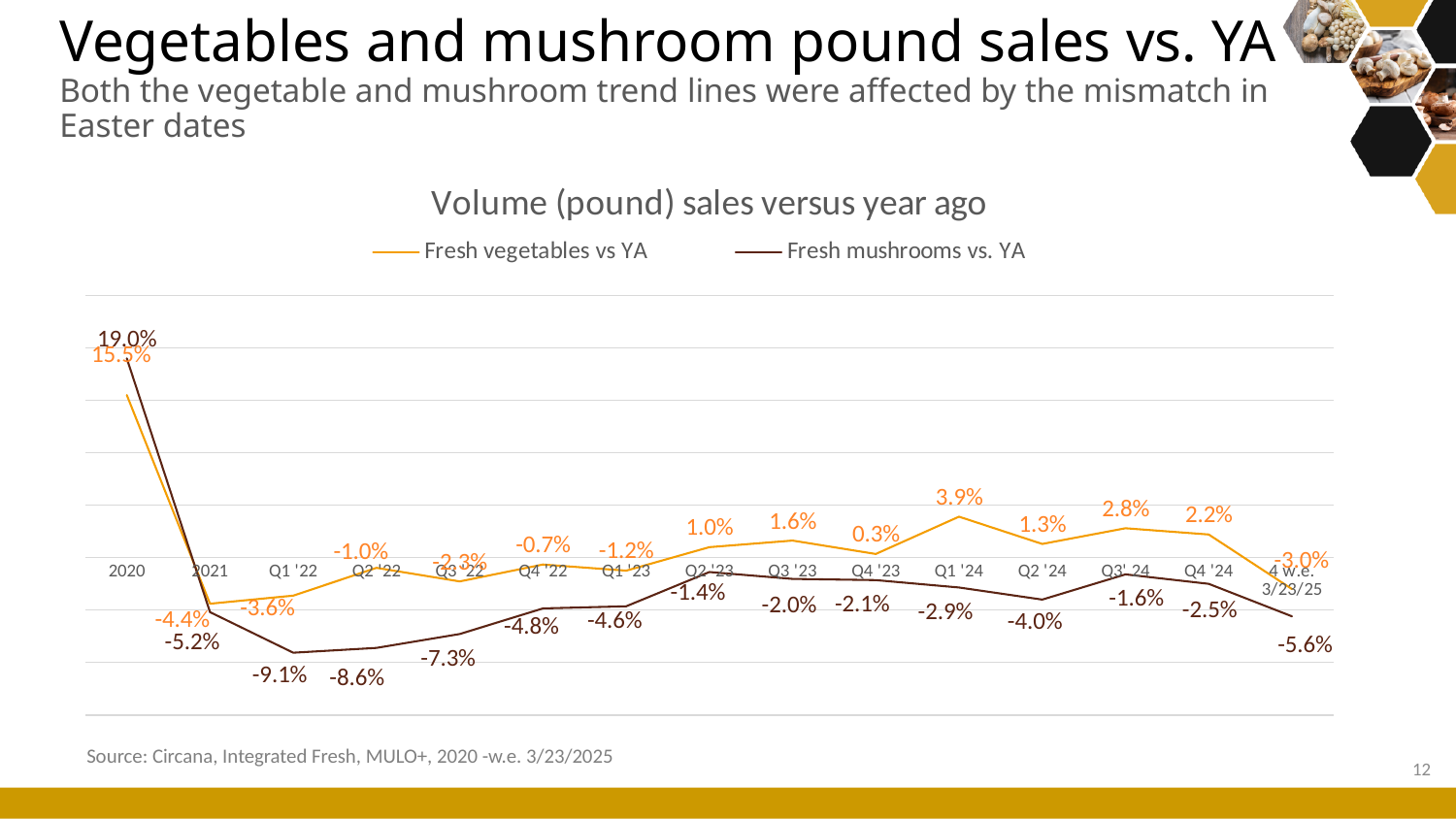
What is the value for Fresh vegetables vs YA in Q1 '24? 3.9% How many series does the legend list? 2 Which series is drawn with the orange line? Fresh vegetables vs YA What is the value for Fresh mushrooms vs. YA in Q1 '22? -9.1% How many time periods are plotted along the x axis? 15 What is the value for Fresh vegetables vs YA for the 4 w.e. 3/23/25 period? -3.0% In Q4 '24, which series has the larger value, Fresh vegetables vs YA or Fresh mushrooms vs. YA? Fresh vegetables vs YA What kind of chart is shown on the slide? Line chart In which period is the Fresh mushrooms vs. YA value lowest? Q1 '22 What is the difference between the Fresh mushrooms and Fresh vegetables values in 2020? 3.5 percentage points In which period is the Fresh mushrooms vs. YA value highest? 2020 In which period is the Fresh vegetables vs YA value highest? 2020